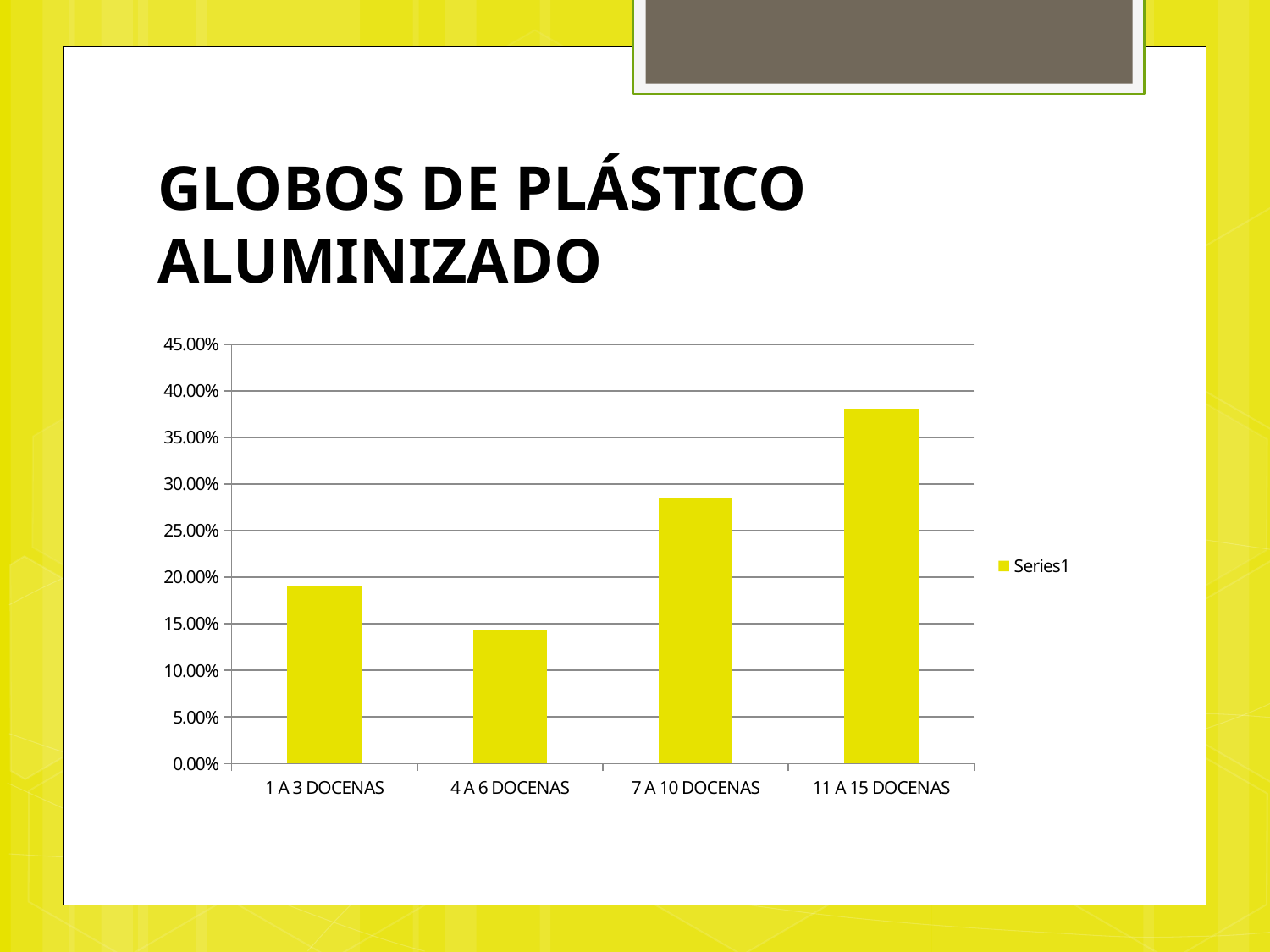
Is the value for 7 A 10 DOCENAS greater or less than 25.00%? greater How many series does the legend list? 1 How many categories are shown on the x axis of the chart? 4 Which is larger, the value for 1 A 3 DOCENAS or the value for 7 A 10 DOCENAS? 7 A 10 DOCENAS Which category has the lowest value? 4 A 6 DOCENAS What is the name of the series shown in the legend? Series1 Is the value for 4 A 6 DOCENAS greater or less than 20.00%? less Which category has the highest value? 11 A 15 DOCENAS What type of chart is shown on the slide? bar chart What is the title of the slide containing the chart? GLOBOS DE PLÁSTICO ALUMINIZADO Is the value for 1 A 3 DOCENAS greater or less than 15.00%? greater